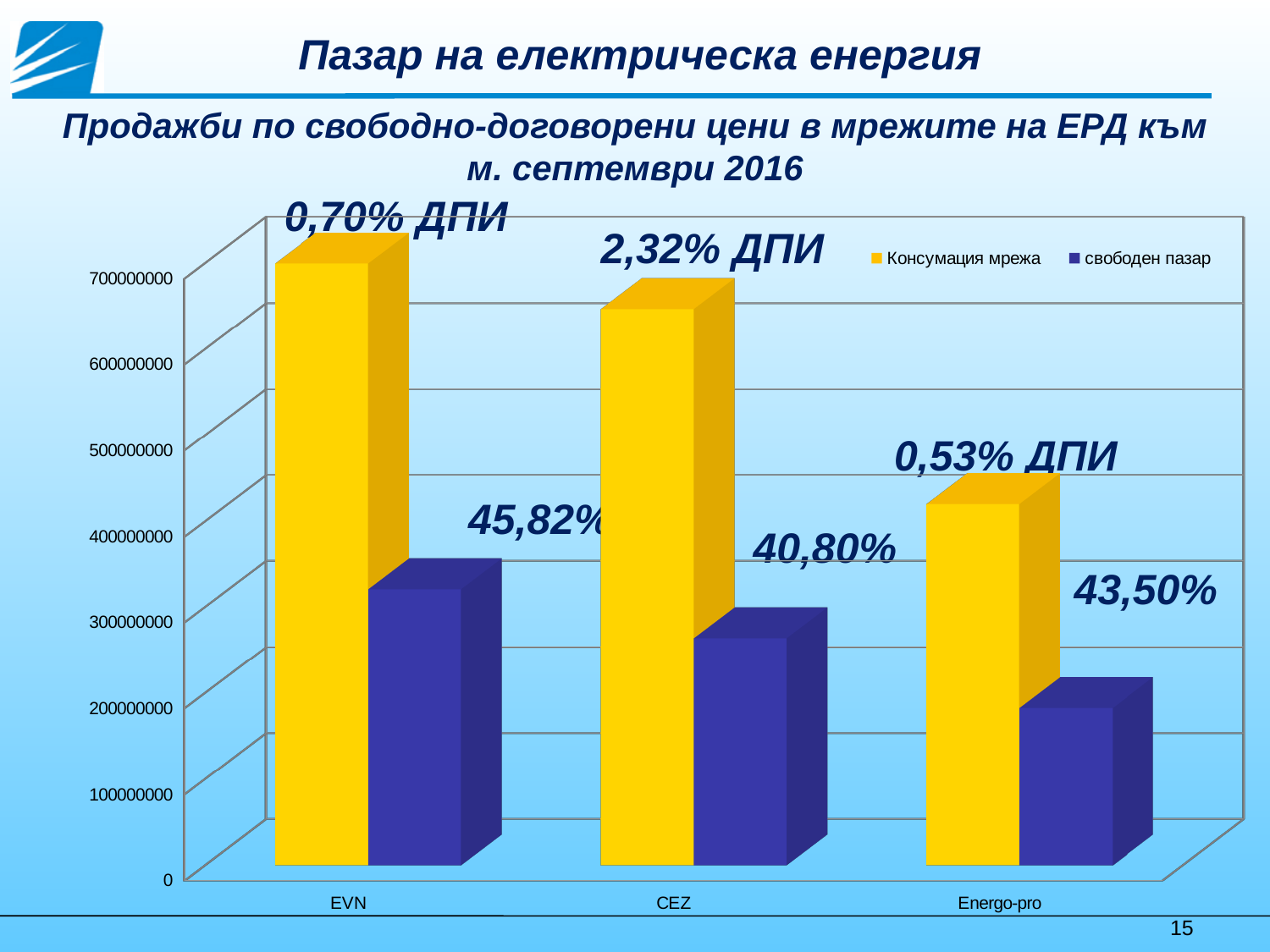
What kind of chart is shown on the slide? bar chart Is the 'Консумация мрежа' value for CEZ greater or less than 600000000? greater Which category has the highest value for the 'Консумация мрежа' series? EVN Which is larger for CEZ: the 'Консумация мрежа' value or the 'свободен пазар' value? Консумация мрежа Which category has the lowest value for the 'свободен пазар' series? Energo-pro Is the 'свободен пазар' value for EVN greater or less than 300000000? greater Which category has the lowest value for the 'Консумация мрежа' series? Energo-pro How many series does the chart legend list? 2 Is the 'Консумация мрежа' value for Energo-pro greater or less than 500000000? less How many categories are shown on the x axis of the chart? 3 What percentage label is shown next to the 'свободен пазар' bar for Energo-pro? 43,50%